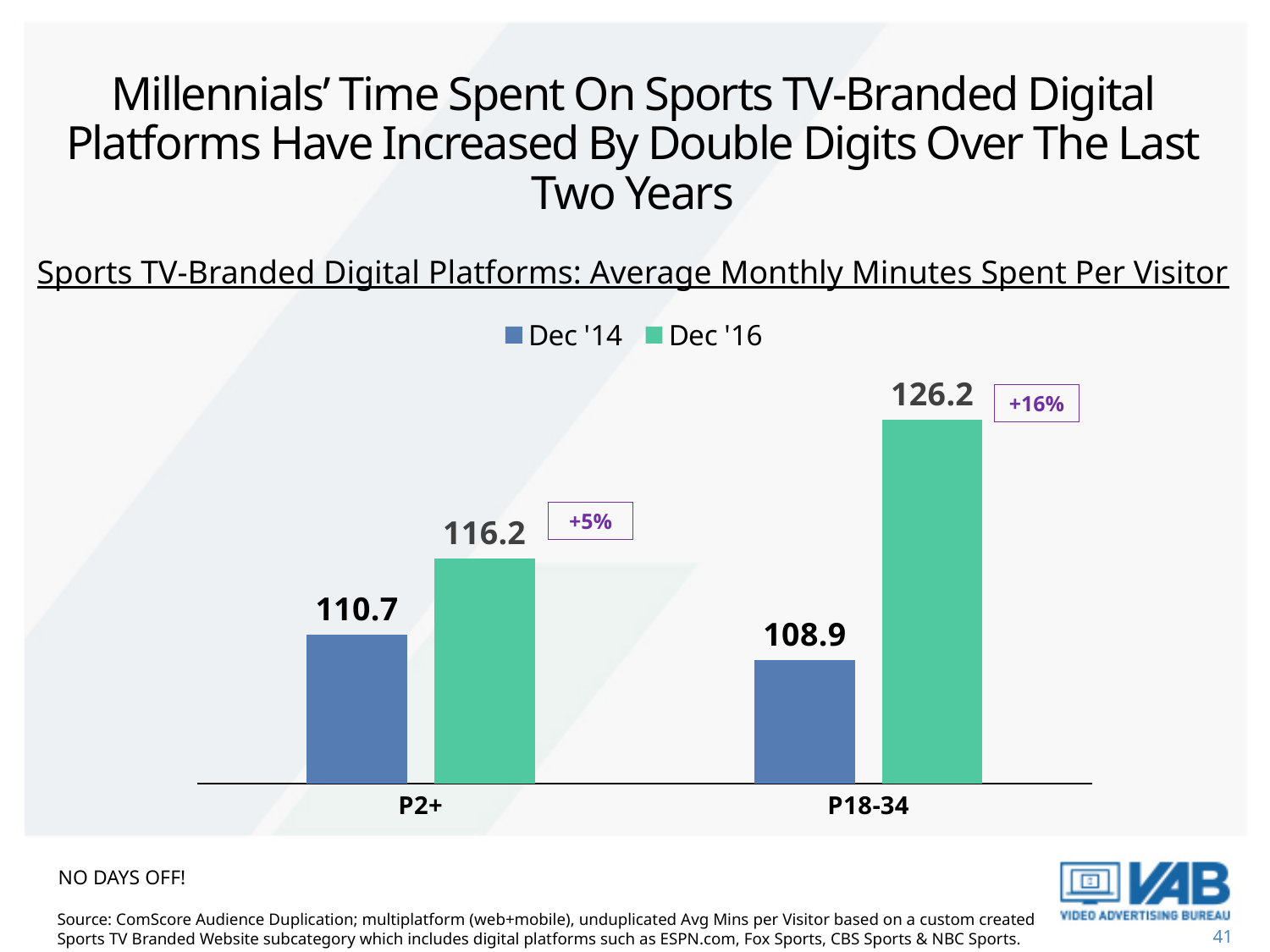
Which is larger for P2+: the Dec '14 value or the Dec '16 value? Dec '16 How many series does the legend list? 2 What is the Dec '14 value for P18-34? 108.9 Which category has the highest Dec '16 value? P18-34 What is the Dec '14 value for P2+? 110.7 What kind of chart is shown on the slide? Bar chart Which category has the lowest Dec '14 value? P18-34 What is the difference between the Dec '16 and Dec '14 values for P2+? 5.5 How many categories are shown on the x axis? 2 What is the Dec '16 value for P2+? 116.2 What is the Dec '16 value for P18-34? 126.2 What is the difference between the Dec '16 and Dec '14 values for P18-34? 17.3